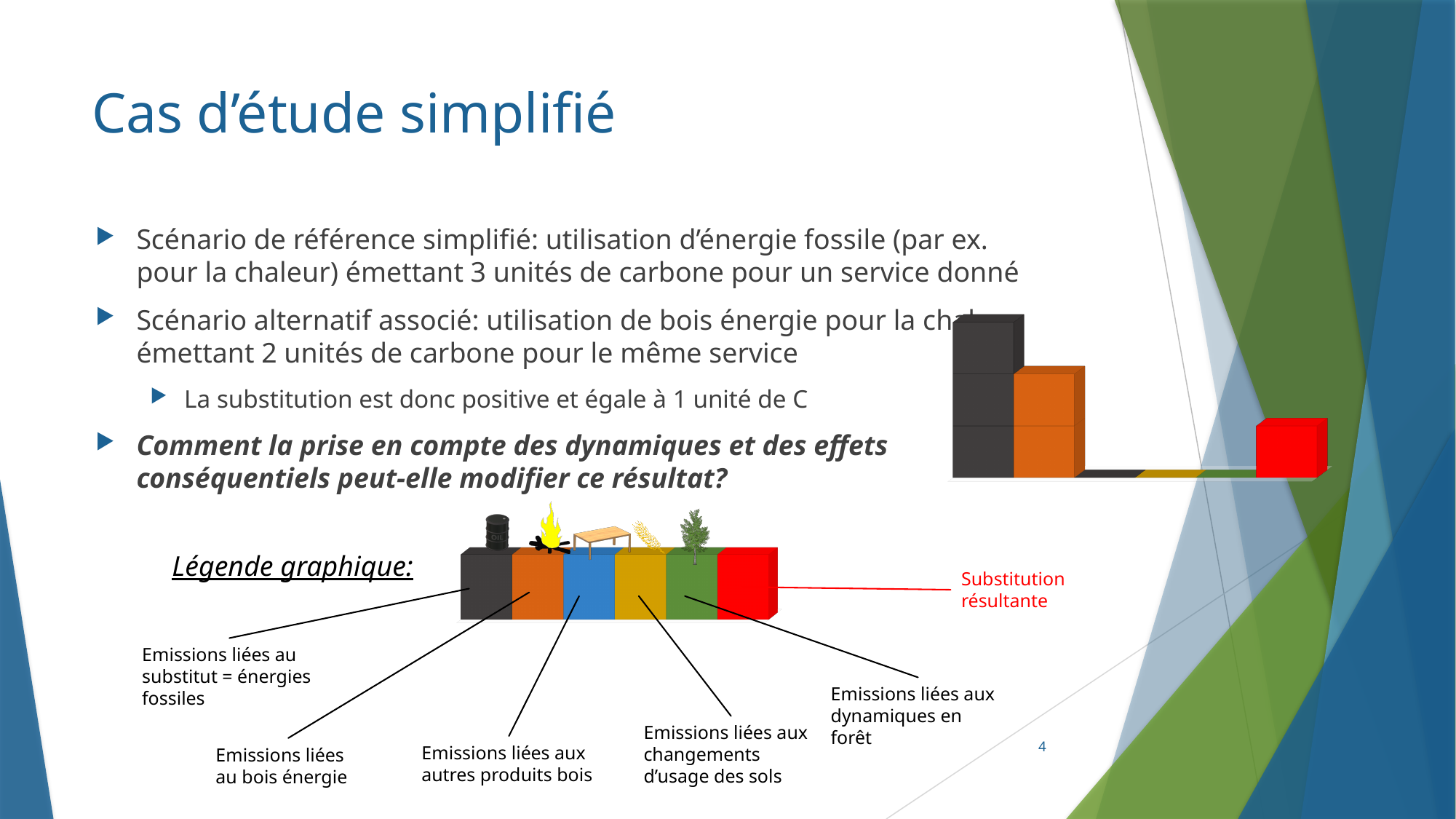
How many stacked segments does the black bar in the chart on the right show? 3 According to the graphic legend, what does the red colour represent? Substitution résultante In the chart on the right, which of the visible bars is the shortest? the red bar (substitution résultante) According to the graphic legend, what does the blue colour represent? Emissions liées aux autres produits bois In the chart on the right, is the orange bar taller or shorter than the red bar? taller What kind of chart is shown on the right side of the slide? bar chart In the chart on the right, which bar is the tallest? the black bar (émissions liées au substitut = énergies fossiles) How many bars with visible height are shown in the chart on the right? 3 In the chart on the right, is the black bar taller or shorter than the orange bar? taller How many stacked segments does the orange bar in the chart on the right show? 2